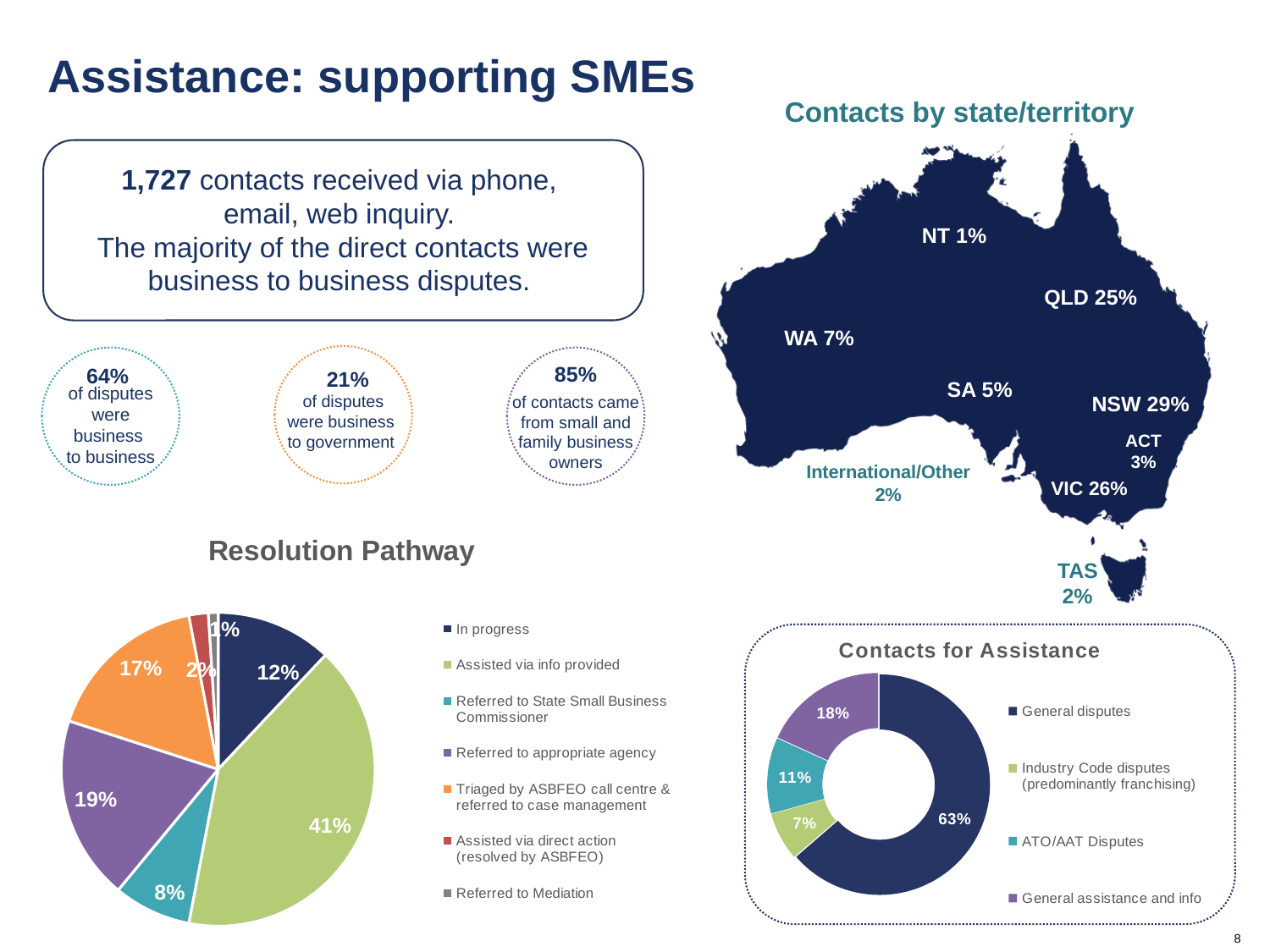
How many categories does the legend of the Contacts for Assistance chart list? 4 In the Resolution Pathway chart, what share of contacts were assisted via info provided? 41% How many categories does the legend of the Resolution Pathway chart list? 7 In the Resolution Pathway chart, which category has the smallest slice? Referred to Mediation In the Contacts for Assistance chart, which category has the smallest share? Industry Code disputes (predominantly franchising) In the Resolution Pathway chart, which category has the largest slice? Assisted via info provided What kind of chart is the Resolution Pathway chart? Pie chart In the Resolution Pathway chart, what is the difference between the share triaged by ASBFEO call centre & referred to case management and the share in progress? 5% In the Contacts for Assistance chart, what share is General disputes? 63% In the Contacts for Assistance chart, which is larger: General assistance and info or ATO/AAT Disputes? General assistance and info In the Resolution Pathway chart, what percentage were referred to appropriate agency? 19% In the Contacts for Assistance chart, what percentage is ATO/AAT Disputes? 11%